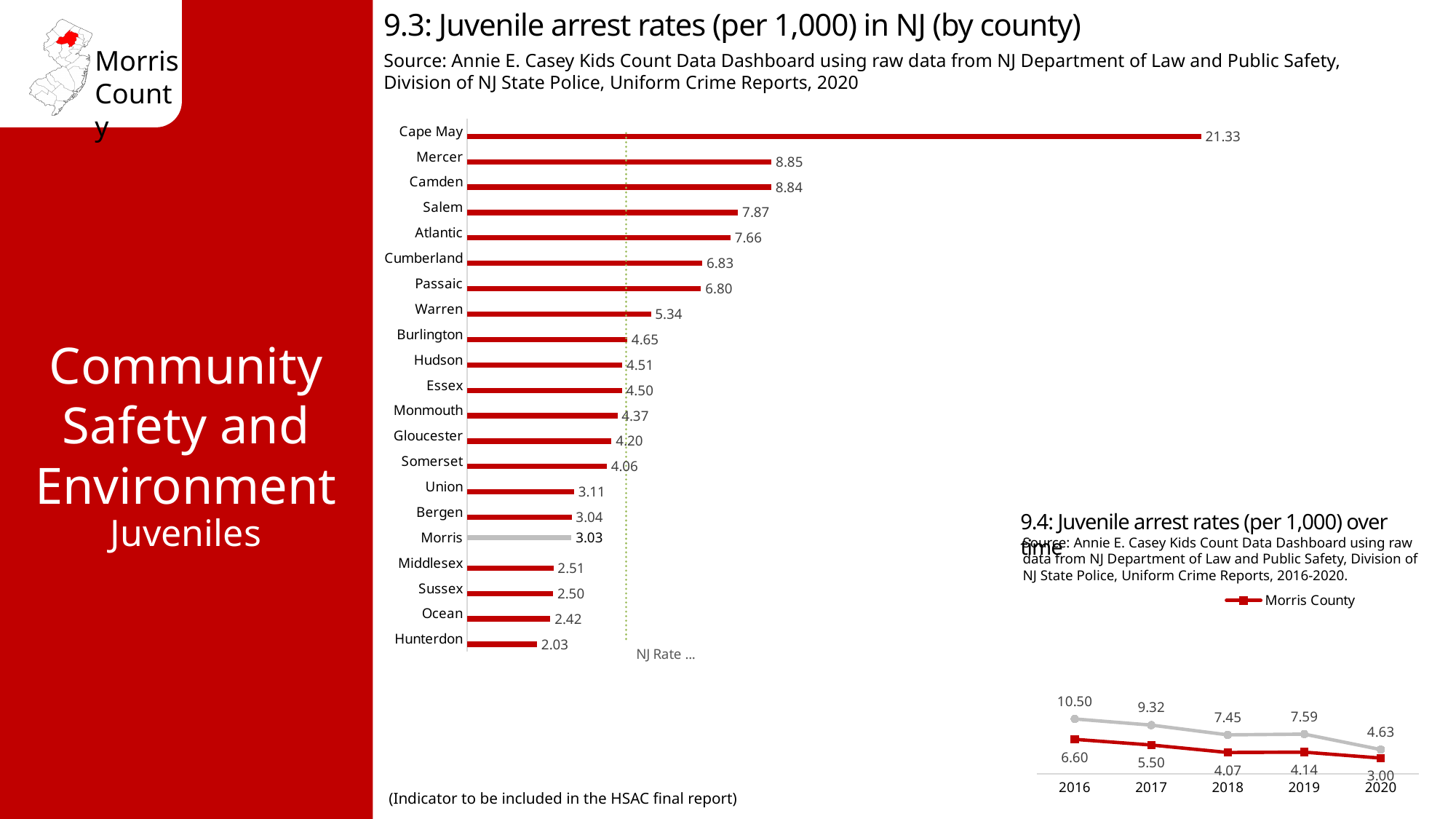
In the chart '9.3: Juvenile arrest rates (per 1,000) in NJ (by county)', what is the value for Morris? 3.03 In the chart '9.4: Juvenile arrest rates (per 1,000) over time', does the Morris County rate rise or fall from 2016 to 2020? Fall What kind of chart is '9.3: Juvenile arrest rates (per 1,000) in NJ (by county)'? Bar chart In the chart '9.3: Juvenile arrest rates (per 1,000) in NJ (by county)', how many counties are plotted? 21 In the chart '9.3: Juvenile arrest rates (per 1,000) in NJ (by county)', which county has the lowest rate? Hunterdon In the chart '9.3: Juvenile arrest rates (per 1,000) in NJ (by county)', what is the difference between the values for Cape May and Mercer? 12.48 In the chart '9.3: Juvenile arrest rates (per 1,000) in NJ (by county)', what is the value for Passaic? 6.80 In the chart '9.3: Juvenile arrest rates (per 1,000) in NJ (by county)', which is larger, the value for Warren or the value for Union? Warren In the chart '9.4: Juvenile arrest rates (per 1,000) over time', how many years are plotted on the x axis? 5 In the chart '9.3: Juvenile arrest rates (per 1,000) in NJ (by county)', which county has the highest rate? Cape May In the chart '9.4: Juvenile arrest rates (per 1,000) over time', what is the Morris County value for 2018? 4.07 In the chart '9.4: Juvenile arrest rates (per 1,000) over time', what is the difference between the Morris County values for 2016 and 2020? 3.60